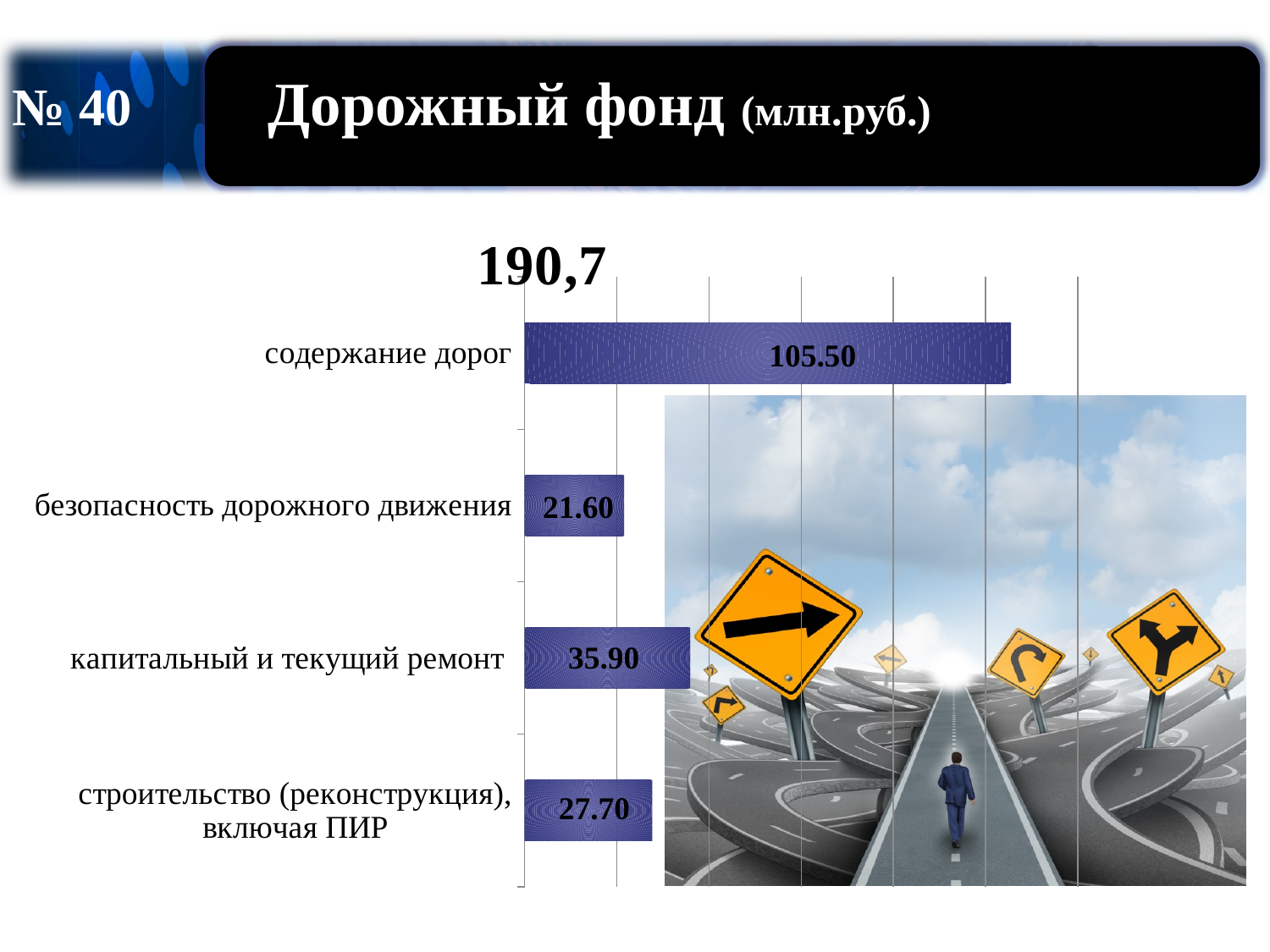
What is the difference between the values for содержание дорог and капитальный и текущий ремонт? 69.60 Which is larger: the value for строительство (реконструкция), включая ПИР or the value for безопасность дорожного движения? строительство (реконструкция), включая ПИР How many categories are shown in the chart? 4 What is the value for безопасность дорожного движения? 21.60 What is the difference between the values for капитальный и текущий ремонт and строительство (реконструкция), включая ПИР? 8.20 What is the value for содержание дорог? 105.50 Which category has the highest value? содержание дорог What is the title of the chart on the slide? 190,7 What is the value for строительство (реконструкция), включая ПИР? 27.70 What is the value for капитальный и текущий ремонт? 35.90 Which category has the lowest value? безопасность дорожного движения What kind of chart is shown on the slide? bar chart